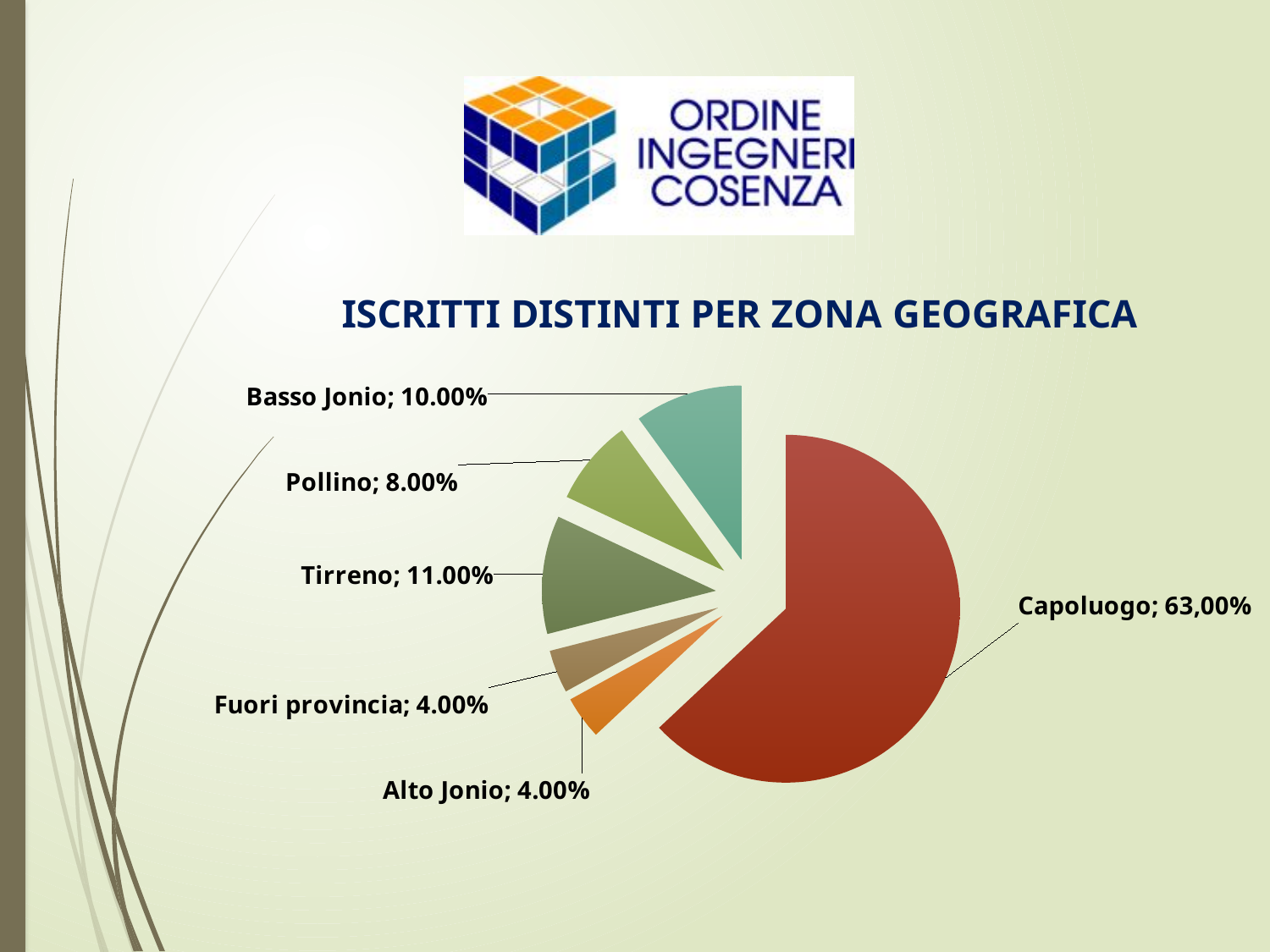
What percentage is shown for Basso Jonio? 10.00% Which is larger, the slice for Basso Jonio or the slice for Pollino? Basso Jonio Which two zones share the smallest slice of the pie? Fuori provincia and Alto Jonio What is the difference in percentage points between Capoluogo and Basso Jonio? 53 How many slices does the pie chart have? 6 What percentage is shown for Capoluogo? 63,00% What percentage is shown for Tirreno? 11.00% What kind of chart is shown on the slide? Pie chart What is the difference in percentage points between Tirreno and Pollino? 3 Which zone has the largest slice of the pie? Capoluogo What is the title of the chart? ISCRITTI DISTINTI PER ZONA GEOGRAFICA What percentage is shown for Pollino? 8.00%